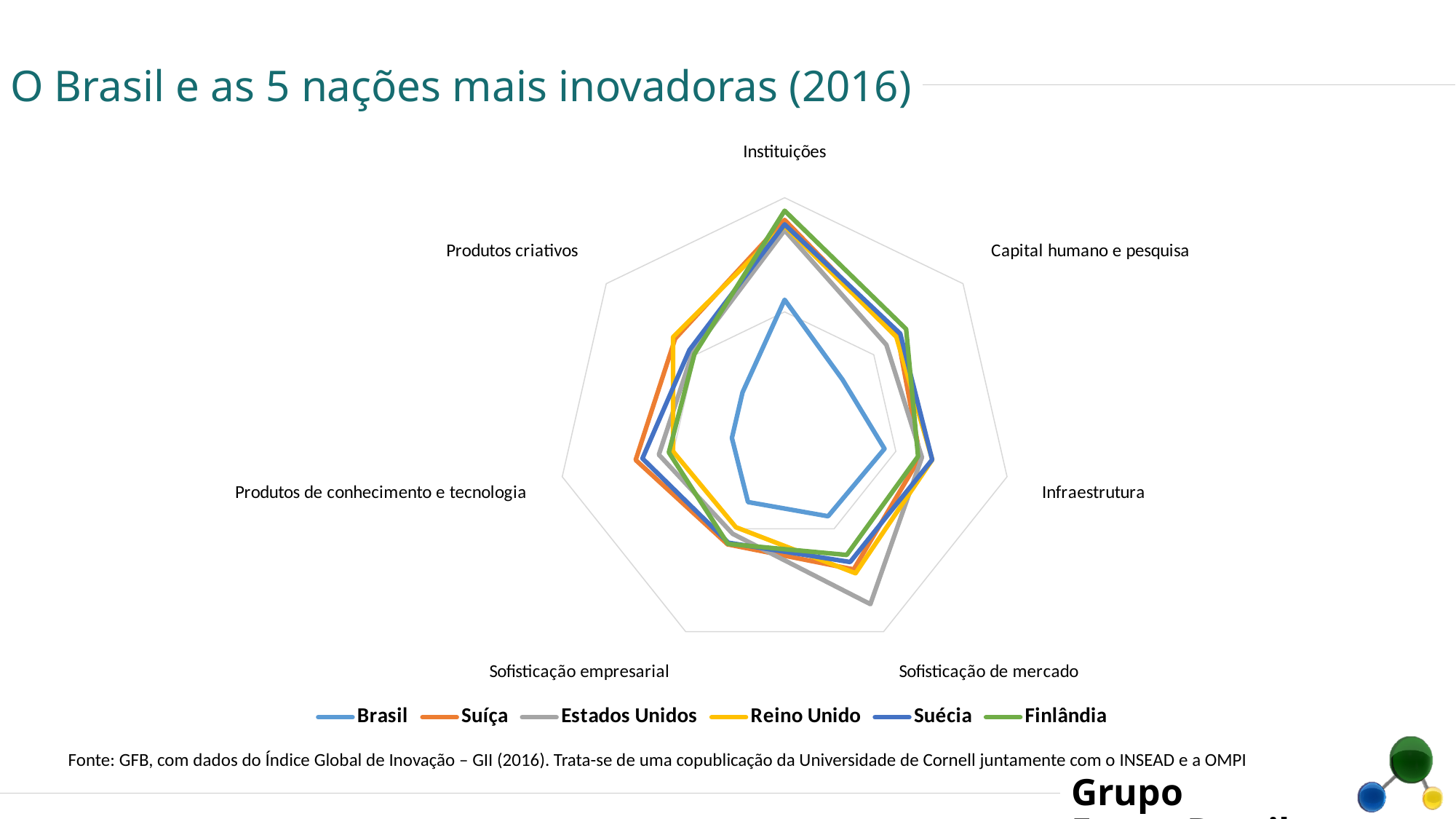
What kind of chart is shown on the slide? Radar chart Which series has the highest value on the Sofisticação de mercado axis? Estados Unidos Which series is drawn in grey in the chart? Estados Unidos What is the title of the slide containing the chart? O Brasil e as 5 nações mais inovadoras (2016) How many categories (axes) does the radar chart have? 7 On the Sofisticação de mercado axis, which is larger: Estados Unidos or Brasil? Estados Unidos Which series has the lowest value on the Sofisticação empresarial axis? Brasil Which series has the lowest value on the Produtos criativos axis? Brasil On the Produtos de conhecimento e tecnologia axis, which is larger: Brasil or Suíça? Suíça How many series does the legend list? 6 Which series has the lowest value on the Infraestrutura axis? Brasil